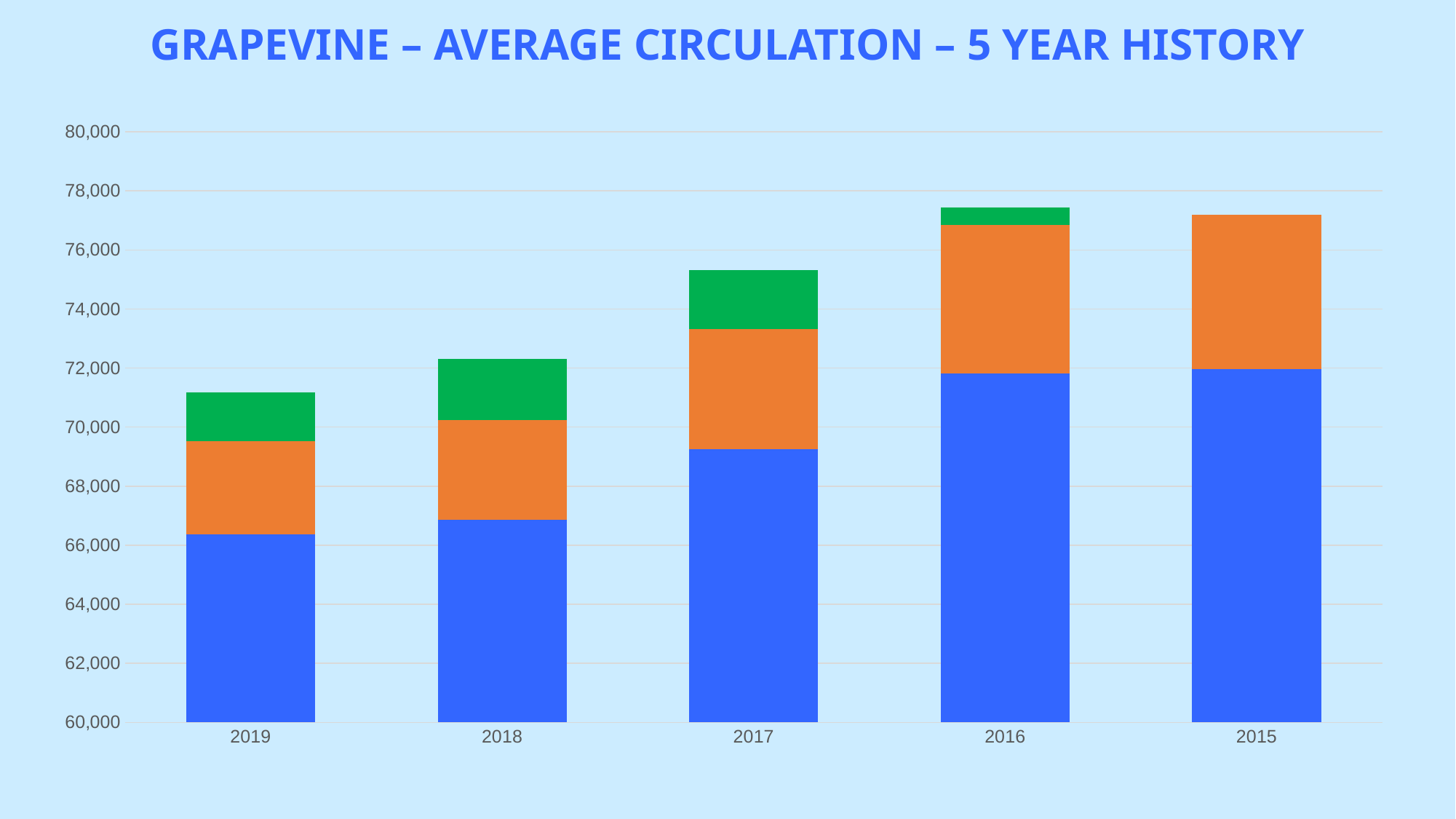
How many years are shown on the x axis? 5 What is the title of the chart? GRAPEVINE – AVERAGE CIRCULATION – 5 YEAR HISTORY Which has the larger total stacked bar, 2017 or 2018? 2017 Is the total stacked bar for 2016 greater or less than 76,000? greater Is the total stacked bar for 2018 greater or less than 74,000? less Is the total stacked bar for 2017 greater or less than 74,000? greater Do the total stacked bars generally rise or fall from left to right along the x axis? rise What kind of chart is shown on the slide? Stacked bar chart Which year has the lowest total stacked bar? 2019